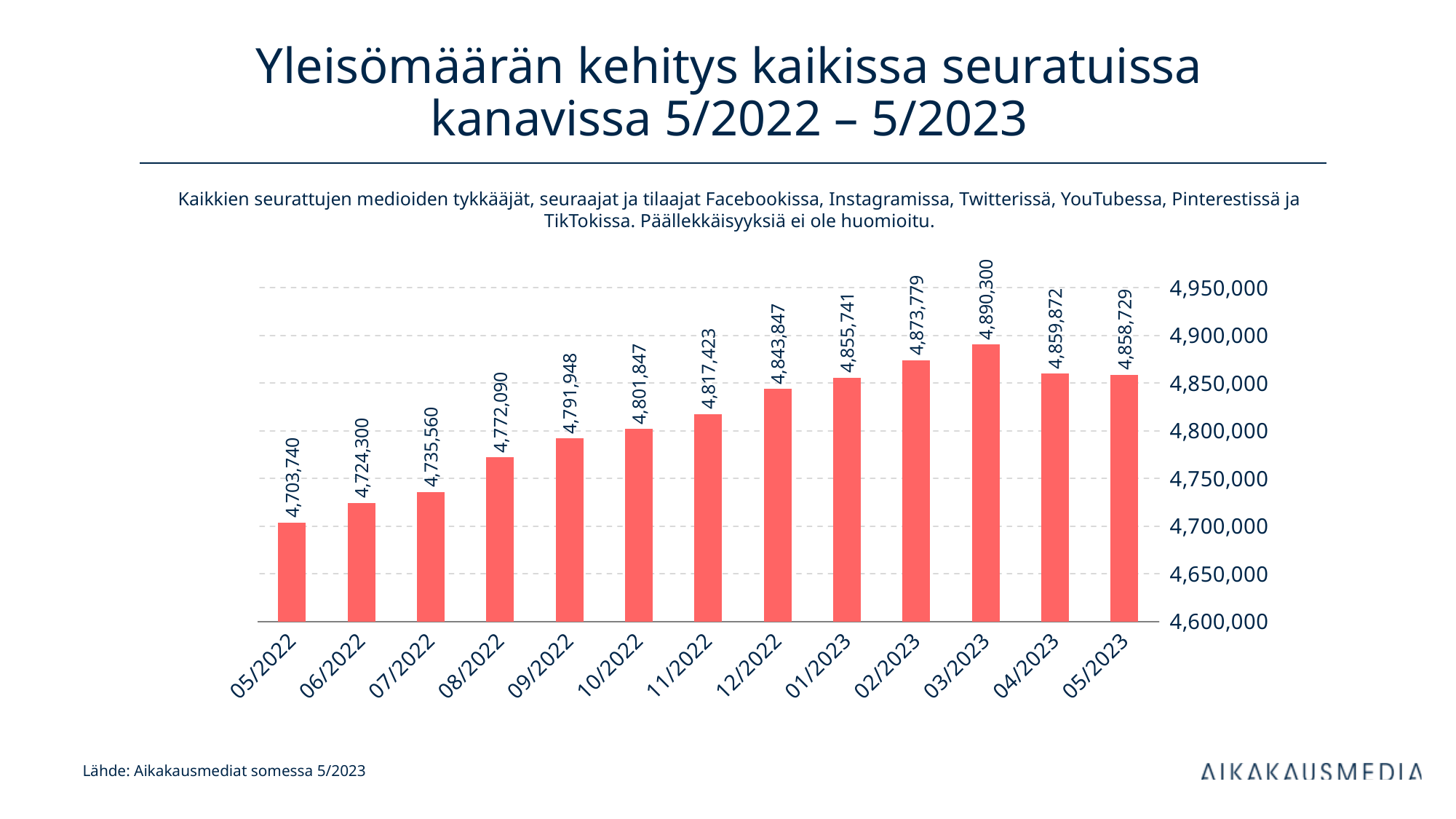
What is the difference between the values for 03/2023 and 05/2022? 186,560 Do the values generally rise or fall from 05/2022 to 03/2023? rise Is the value for 07/2022 greater or less than 4,750,000? less Which is larger, the value for 12/2022 or the value for 08/2022? 12/2022 What is the value for 05/2022? 4,703,740 What kind of chart is shown on the slide? bar chart What is the difference between the values for 05/2023 and 05/2022? 154,989 What is the value for 03/2023? 4,890,300 Which month has the lowest value? 05/2022 What is the value for 12/2022? 4,843,847 Which month has the highest value? 03/2023 How many months are shown on the x axis? 13